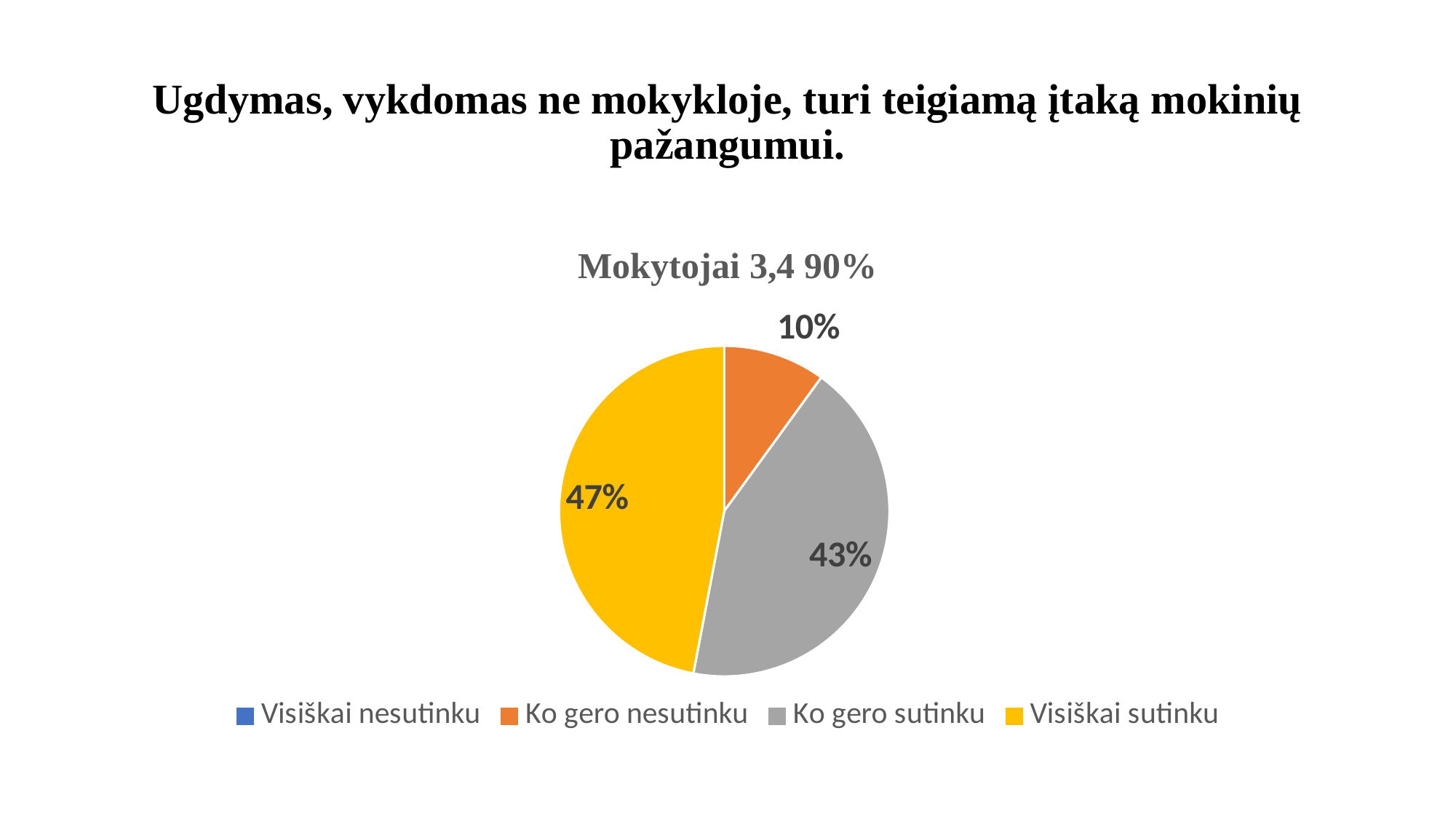
What colour is the slice for "Visiškai sutinku"? yellow What type of chart is shown on the slide? pie chart What percentage is shown for "Visiškai sutinku"? 47% Which labelled category has the smallest slice of the pie? Ko gero nesutinku What percentage is shown for "Ko gero nesutinku"? 10% What is the chart's title? Mokytojai 3,4 90% Which is larger, the slice for "Ko gero sutinku" or the slice for "Ko gero nesutinku"? Ko gero sutinku What is the combined share of "Ko gero sutinku" and "Visiškai sutinku"? 90% Which category has the largest slice of the pie? Visiškai sutinku What is the difference in percentage points between "Visiškai sutinku" and "Ko gero sutinku"? 4 What percentage is shown for "Ko gero sutinku"? 43% How many categories does the legend list? 4